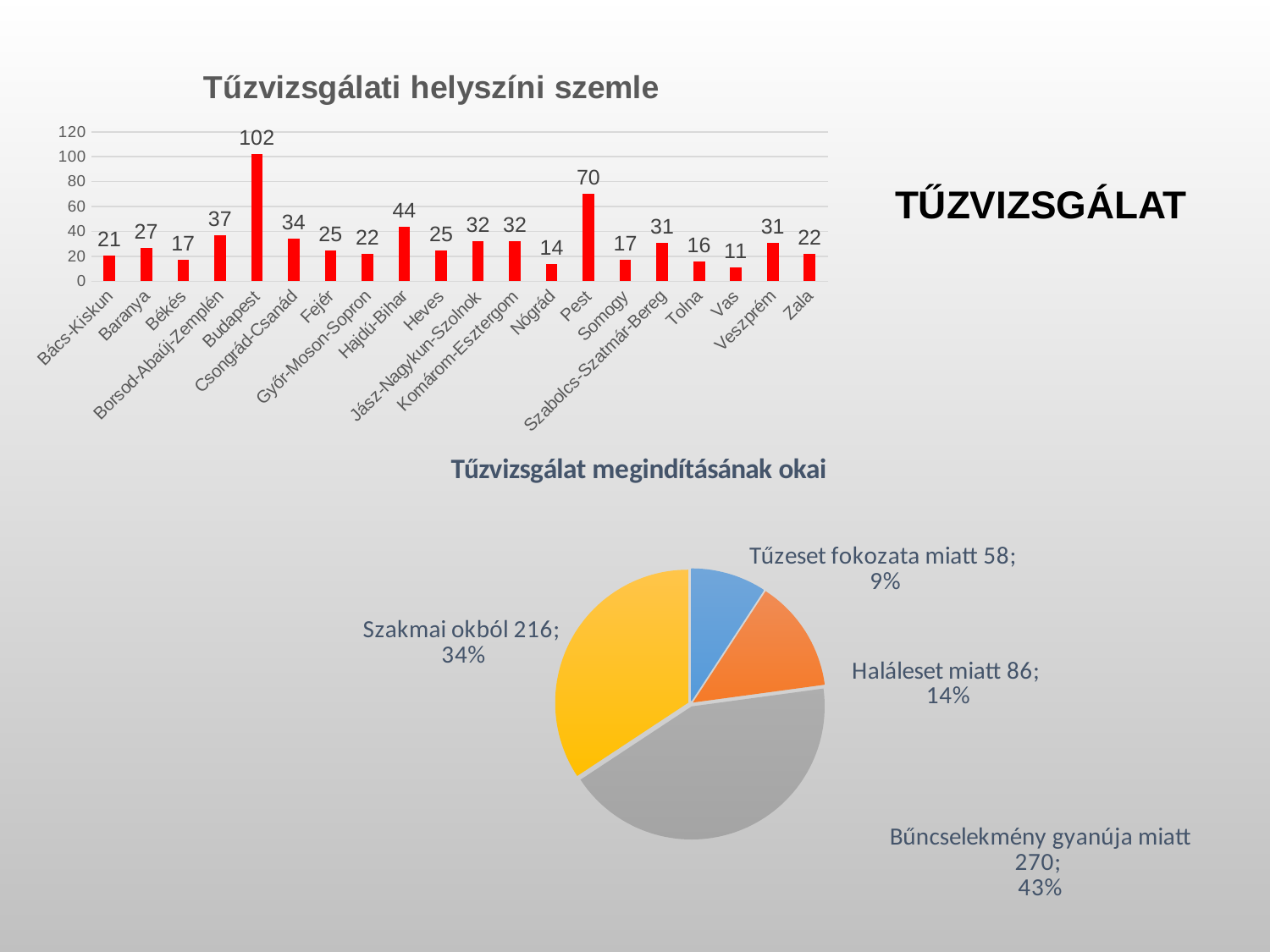
In the 'Tűzvizsgálati helyszíni szemle' chart, which category has the lowest value? Vas In the 'Tűzvizsgálati helyszíni szemle' chart, what is the value for Budapest? 102 In the 'Tűzvizsgálati helyszíni szemle' chart, what is the value for Hajdú-Bihar? 44 In the 'Tűzvizsgálati helyszíni szemle' chart, which category has the highest value? Budapest In the 'Tűzvizsgálat megindításának okai' chart, what share of the pie is 'Szakmai okból'? 34% In the 'Tűzvizsgálat megindításának okai' chart, which slice is the smallest? Tűzeset fokozata miatt In the 'Tűzvizsgálat megindításának okai' chart, what is the value for 'Bűncselekmény gyanúja miatt'? 270 In the 'Tűzvizsgálati helyszíni szemle' chart, which is larger, the value for Baranya or the value for Békés? Baranya In the 'Tűzvizsgálati helyszíni szemle' chart, what is the difference between the values for Budapest and Pest? 32 What kind of chart is 'Tűzvizsgálati helyszíni szemle'? bar chart What kind of chart is 'Tűzvizsgálat megindításának okai'? pie chart How many categories are shown in the 'Tűzvizsgálati helyszíni szemle' chart? 20